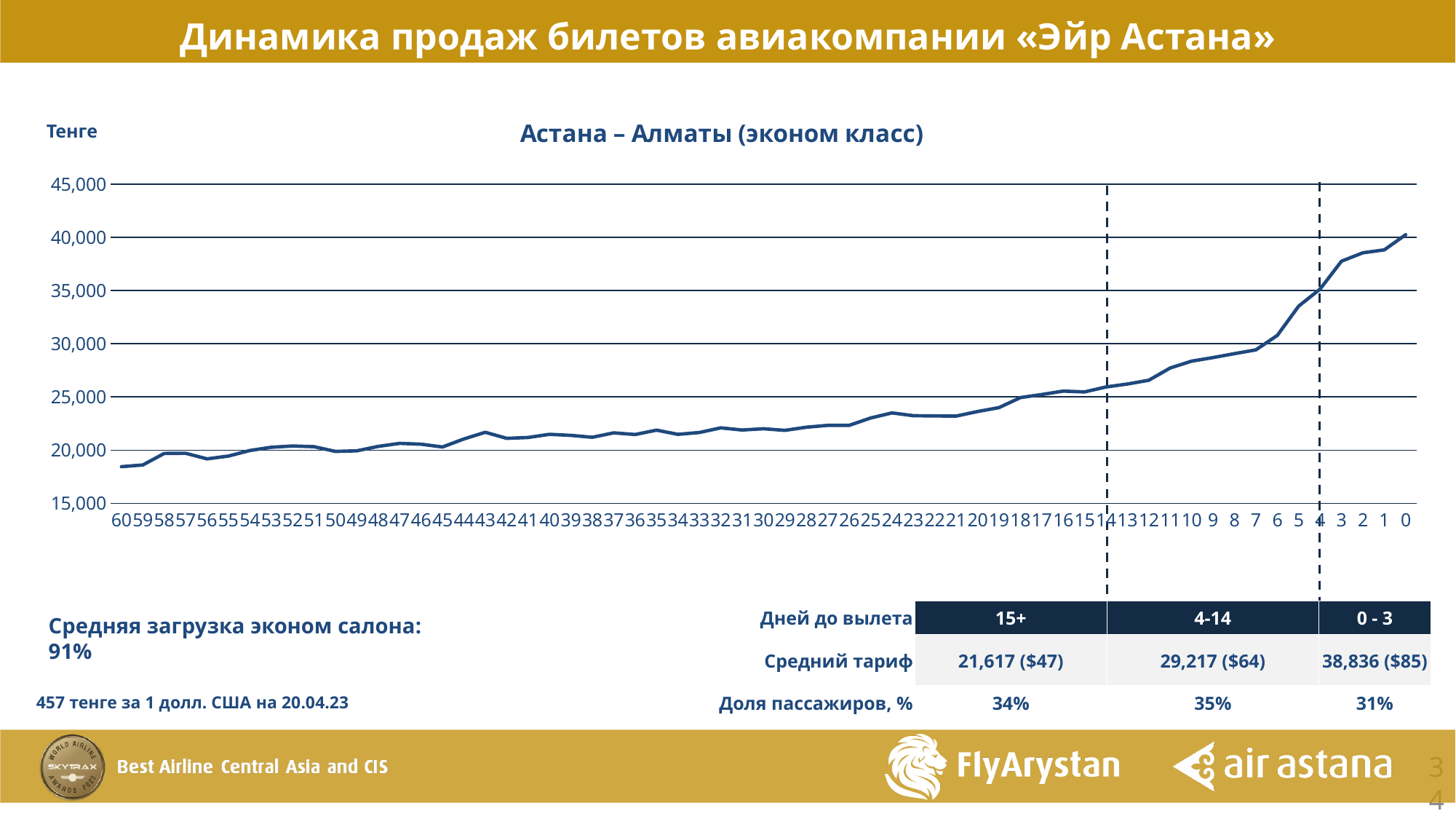
What is the title of the chart? Астана – Алматы (эконом класс) What unit is shown on the y axis of the chart? Тенге At how many days before departure is the ticket price highest? 0 Which is larger: the ticket price at 0 days before departure or at 60 days before departure? 0 days before departure Do the ticket prices rise or fall as the number of days before departure decreases from 60 to 0 along the x axis? rise Is the ticket price at 60 days before departure greater or less than 20,000? less Is the ticket price at 10 days before departure greater or less than 25,000? greater Is the ticket price at 3 days before departure greater or less than 35,000? greater What kind of chart is shown on the slide? line chart According to the table below the chart, what is the average fare for tickets bought 0-3 days before departure? 38,836 ($85) According to the table below the chart, what share of passengers buy tickets 4-14 days before departure? 35%